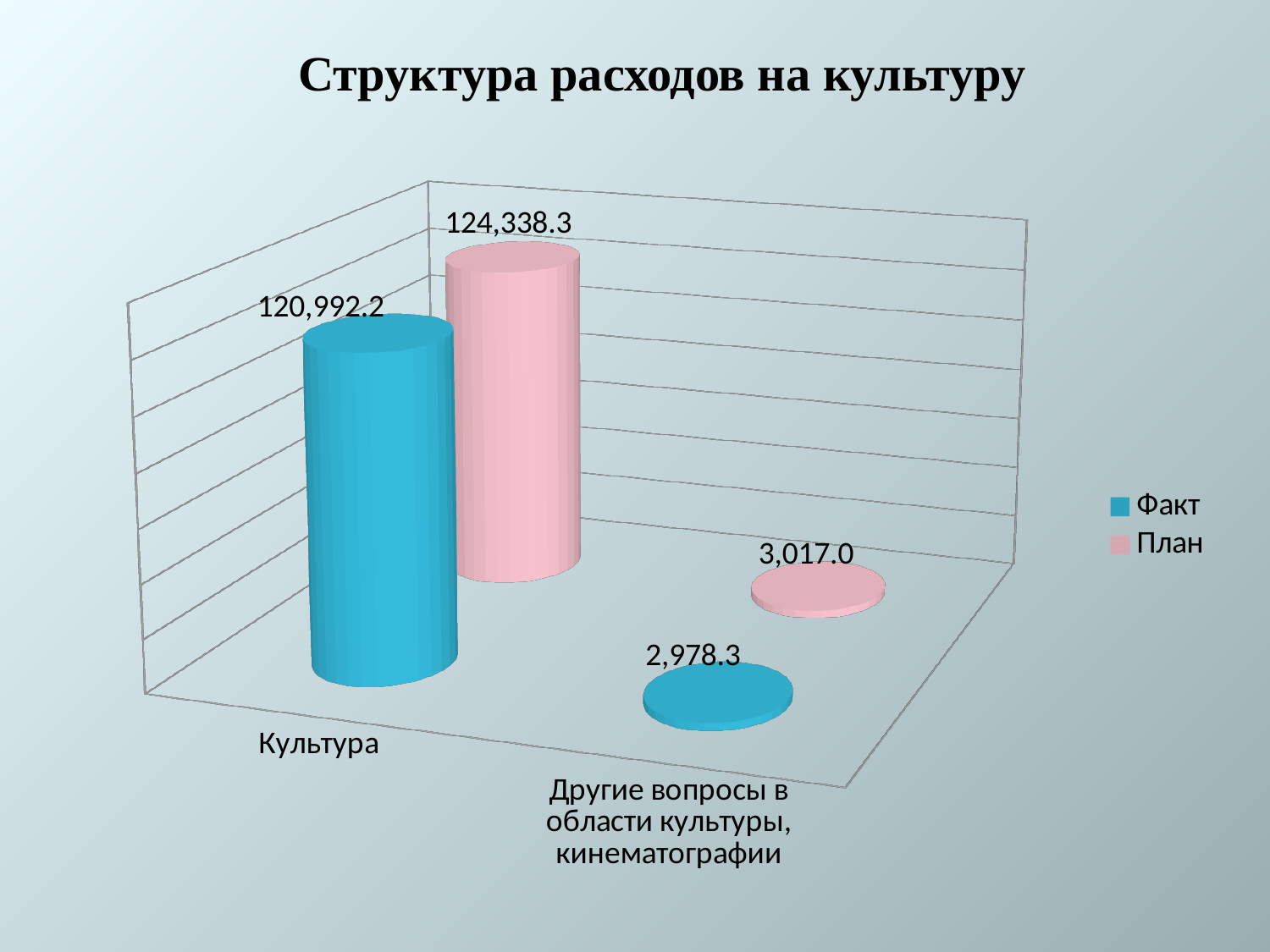
What is the Факт value for Другие вопросы в области культуры, кинематографии? 2,978.3 Which category has the highest План value? Культура What is the План value for Другие вопросы в области культуры, кинематографии? 3,017.0 What is the Факт value for Культура? 120,992.2 How many series does the legend list? 2 What is the difference between the План and Факт values for Культура? 3,346.1 What is the difference between the План and Факт values for Другие вопросы в области культуры, кинематографии? 38.7 How many categories are shown on the x axis? 2 What is the План value for Культура? 124,338.3 Which category has the lowest Факт value? Другие вопросы в области культуры, кинематографии What is the title of the chart? Структура расходов на культуру For Культура, which is larger: the Факт value or the План value? План